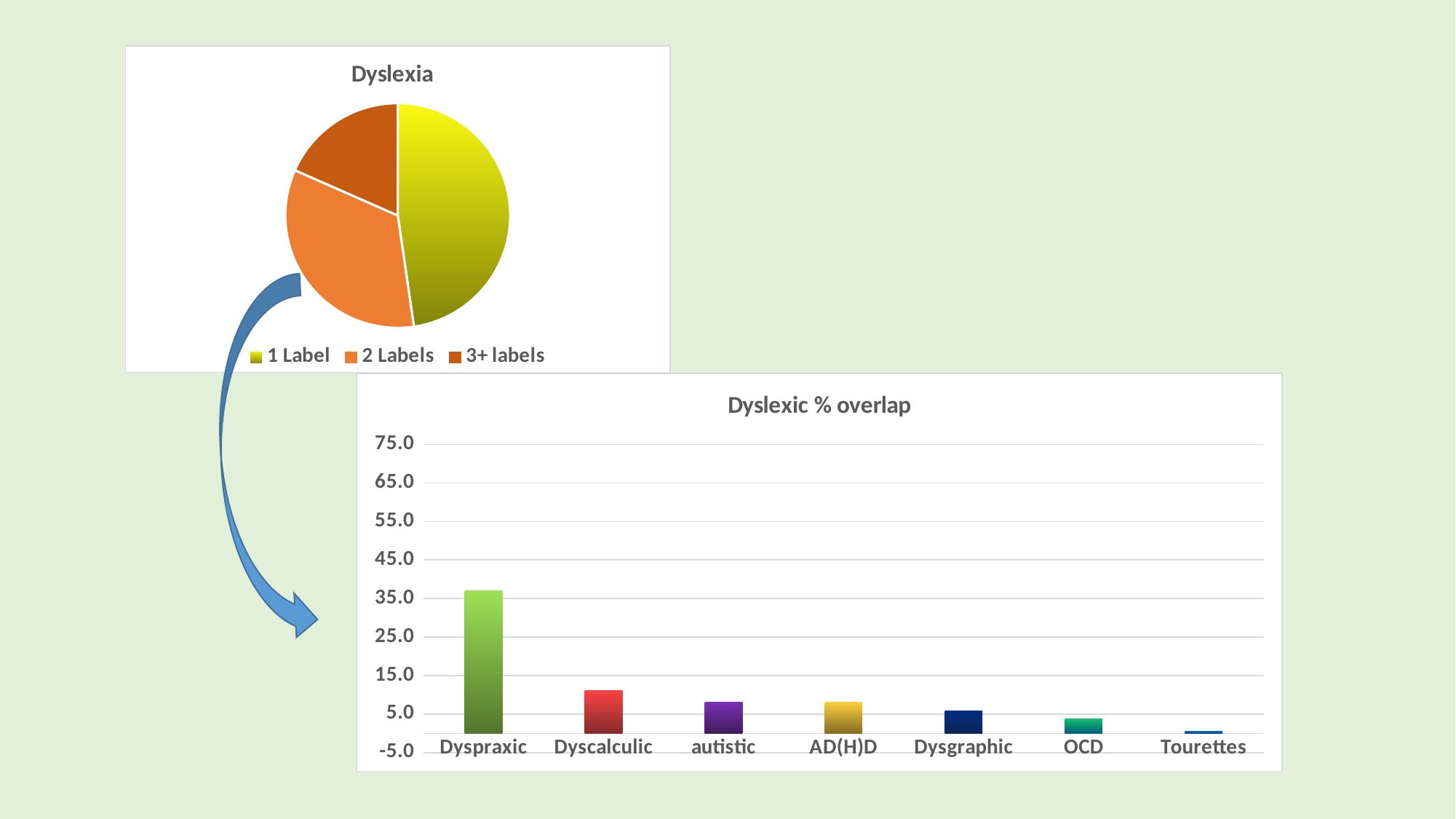
In the 'Dyslexic % overlap' chart, is the value for Dyspraxic greater or less than 25.0? greater In the 'Dyslexia' pie chart, which category has the largest slice? 1 Label In the 'Dyslexia' pie chart, which category has the smallest slice? 3+ labels What kind of chart is the 'Dyslexic % overlap' chart? bar chart How many slices does the 'Dyslexia' pie chart have? 3 In the 'Dyslexic % overlap' chart, which is larger, the value for Dyscalculic or the value for OCD? Dyscalculic In the 'Dyslexic % overlap' chart, which category has the lowest value? Tourettes In the 'Dyslexia' pie chart, what colour is the '2 Labels' slice? orange How many categories are shown in the 'Dyslexic % overlap' chart? 7 What kind of chart is the 'Dyslexia' chart? pie chart In the 'Dyslexic % overlap' chart, which category has the highest value? Dyspraxic In the 'Dyslexic % overlap' chart, is the value for OCD greater or less than 5.0? less